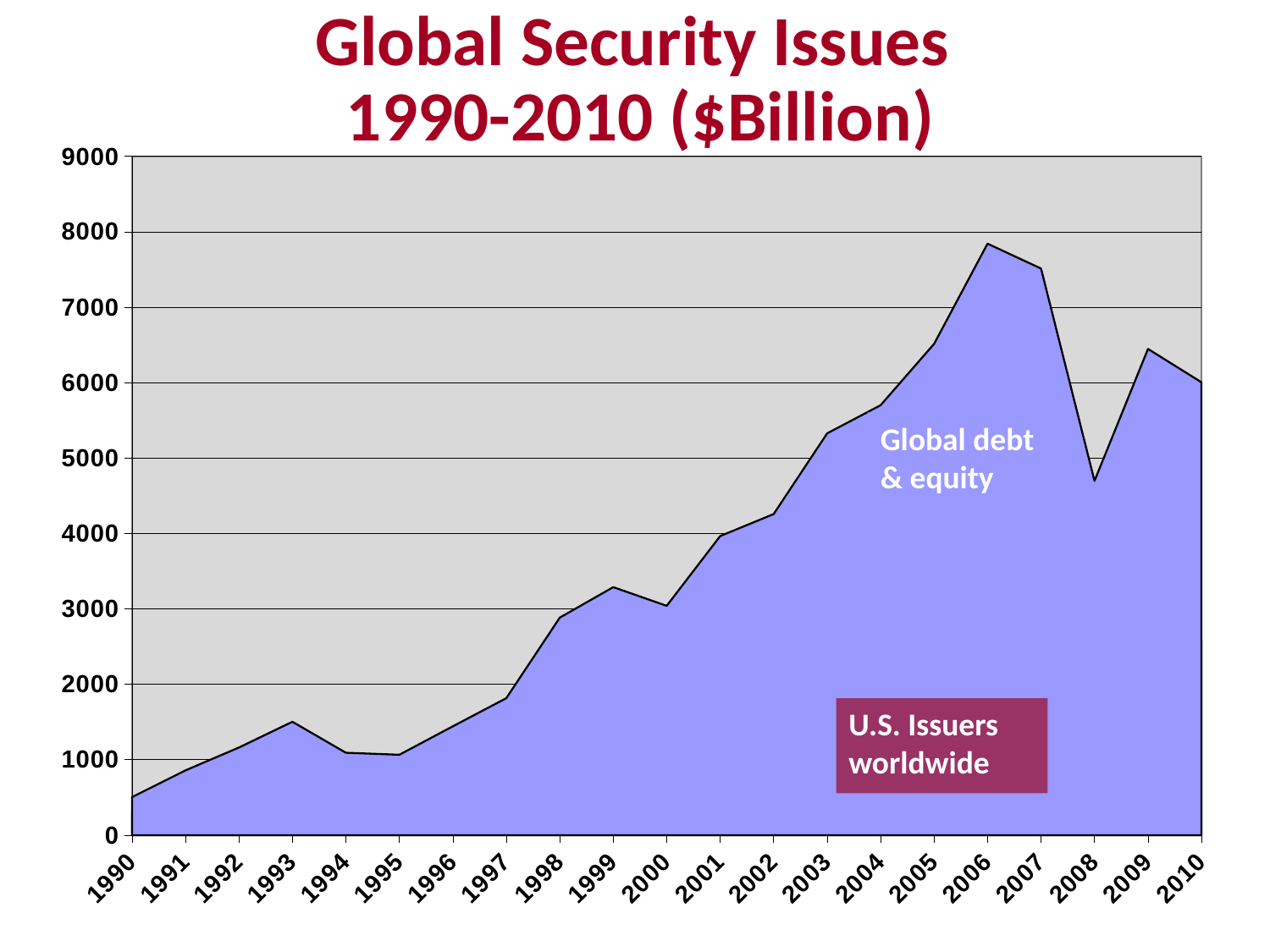
Is the value for 2003 greater or less than 5000? greater Is the value for 1990 greater or less than 1000? less What is the title of the chart? Global Security Issues 1990-2010 ($Billion) Does the value rise or fall from 2007 to 2008? fall Is the value for 2008 greater or less than 5000? less Which year has the larger value, 1993 or 1994? 1993 What kind of chart is shown on the slide? Area chart How many years are shown on the x axis? 21 In which year is the plotted value lowest? 1990 Which year has the larger value, 2007 or 2008? 2007 In which year does the chart reach its highest value? 2006